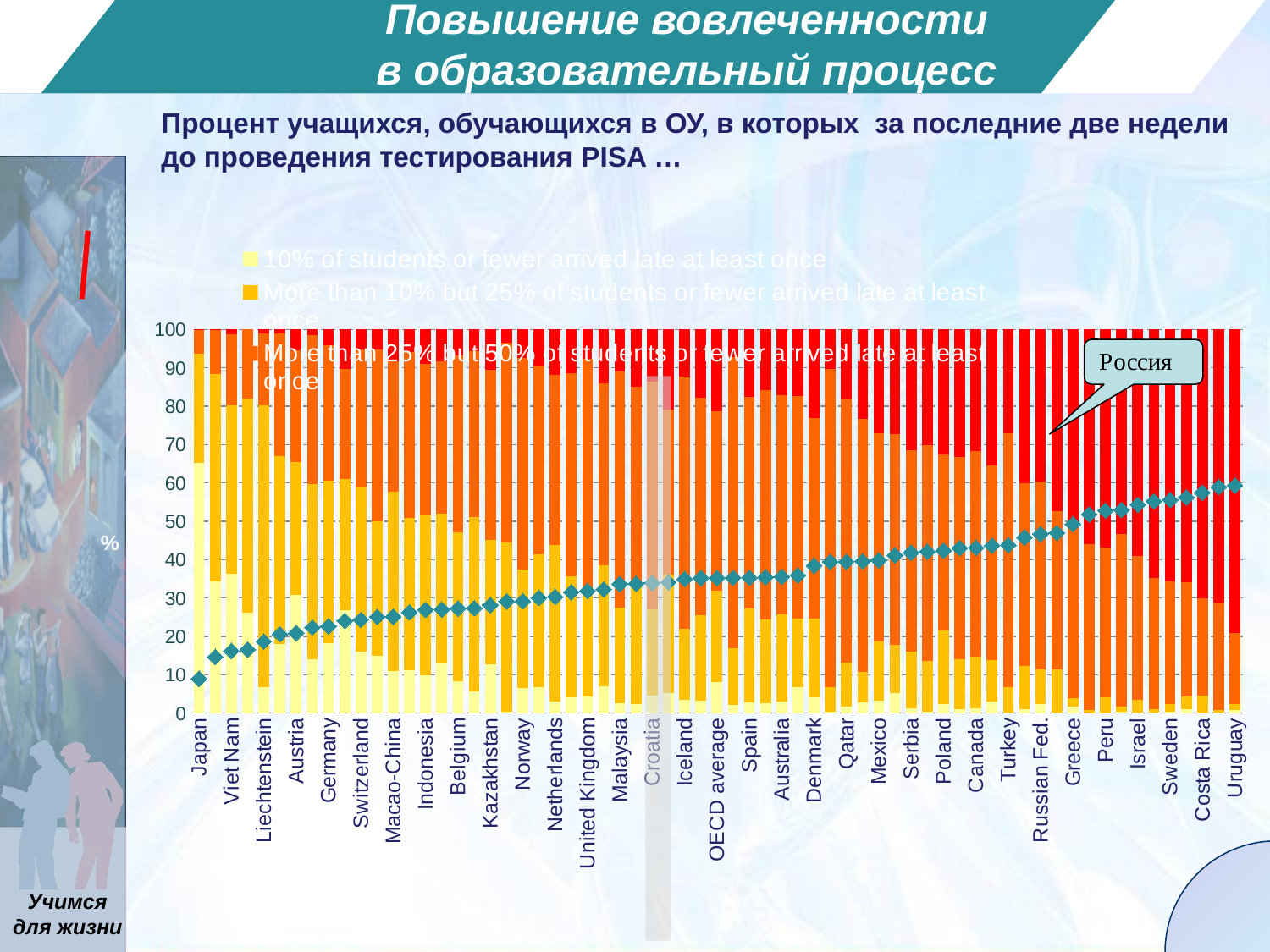
Which country is the rightmost category on the x axis? Uruguay Which country is the leftmost category on the x axis? Japan Which has the larger diamond marker value, Japan or Uruguay? Uruguay Is the diamond marker value for Russian Fed. greater or less than 40? greater What is the highest value shown on the y axis? 100 Is the diamond marker value for Uruguay greater or less than 50? greater What kind of chart is shown on the slide? combination bar and line chart Is the diamond marker value for Japan greater or less than 20? less Do the diamond markers rise or fall moving from left to right along the x axis? rise Which has the larger diamond marker value, OECD average or Russian Fed.? Russian Fed.